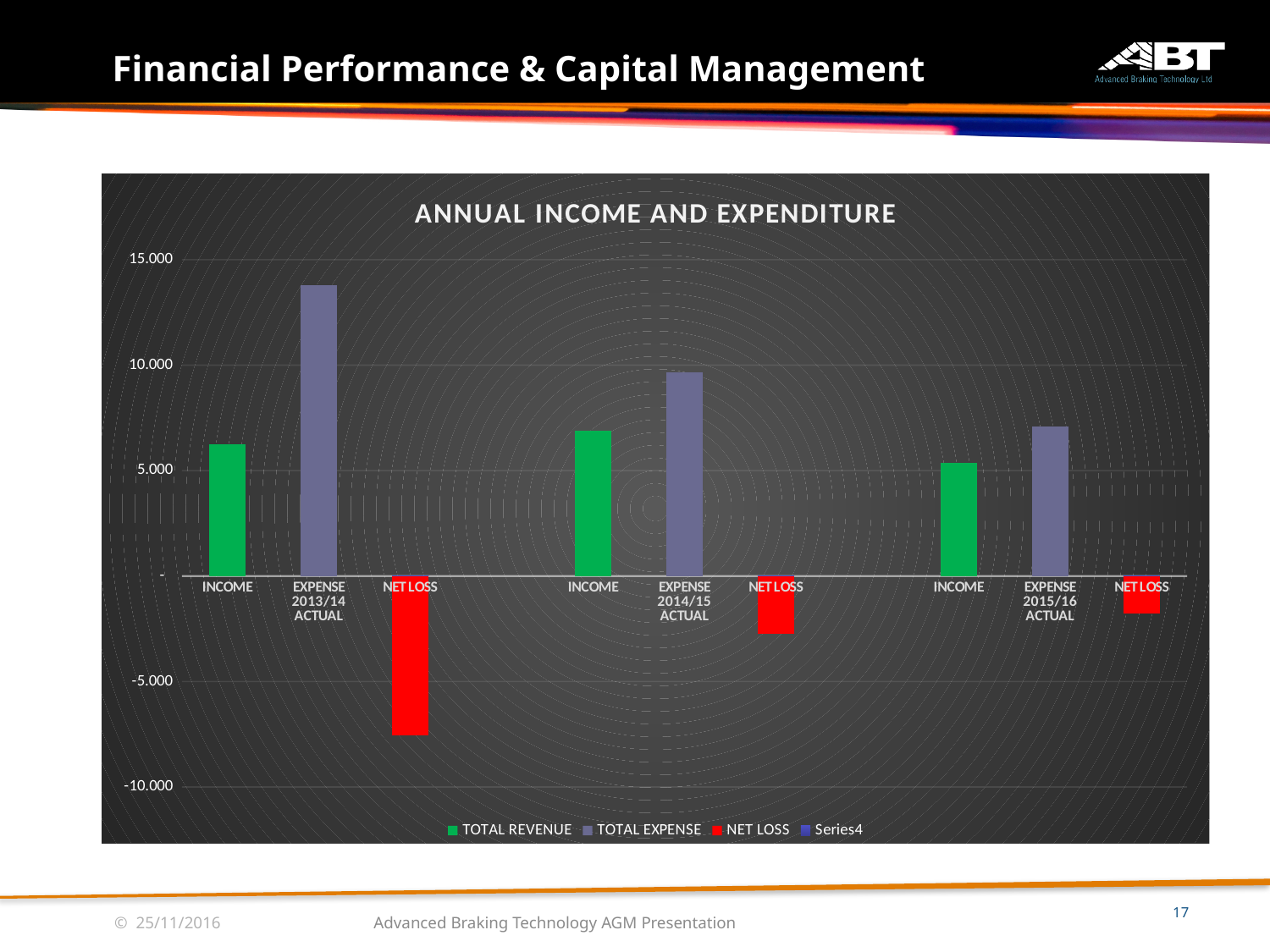
What kind of chart is shown on the slide? bar chart Is the value for INCOME in 2013/14 greater or less than 5.000? greater Is the NET LOSS for 2013/14 greater or less than -5.000? less Do the EXPENSE bars rise or fall from 2013/14 to 2015/16? fall Is the NET LOSS for 2014/15 greater or less than -5.000? greater Which bar extends furthest below zero in the chart? NET LOSS for 2013/14 Which bar is the tallest in the chart? EXPENSE 2013/14 ACTUAL What is the title of the chart? ANNUAL INCOME AND EXPENDITURE How many entries does the chart's legend list? 4 How many bars are plotted in the chart? 9 Which is larger, the EXPENSE for 2013/14 or the EXPENSE for 2014/15? EXPENSE for 2013/14